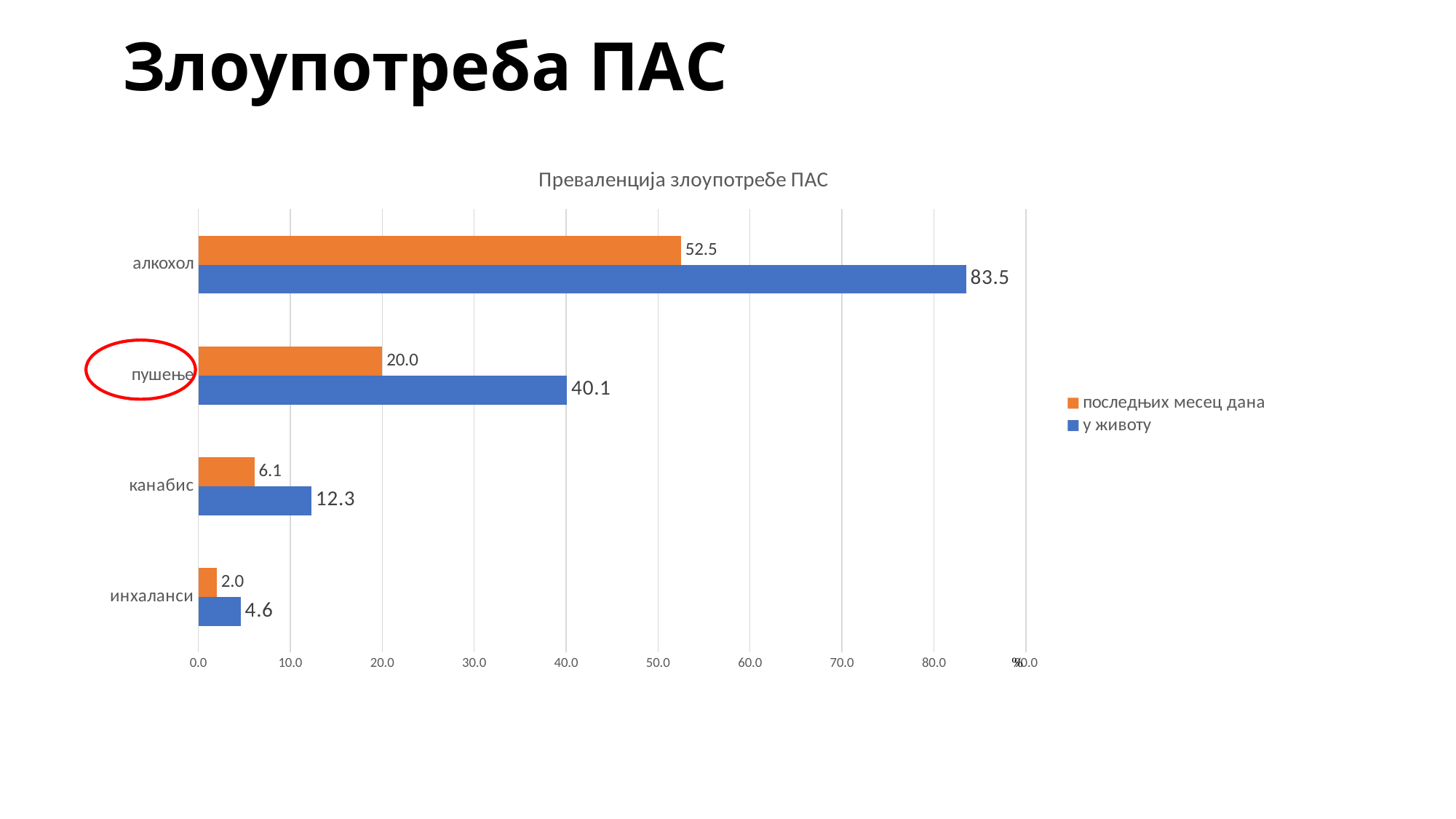
How many categories are shown on the chart? 4 Which is larger: the у животу value for канабис or the последњих месец дана value for пушење? последњих месец дана value for пушење What is the value for пушење in the последњих месец дана series? 20.0 What kind of chart is shown on the slide? bar chart What is the difference between the у животу and последњих месец дана values for пушење? 20.1 What is the value for канабис in the у животу series? 12.3 What is the value for инхаланси in the последњих месец дана series? 2.0 How many series does the legend list? 2 Which category has the lowest value in the последњих месец дана series? инхаланси What is the value for алкохол in the у животу series? 83.5 What is the title of the chart? Преваленција злоупотребе ПАС Which category has the highest value in the у животу series? алкохол